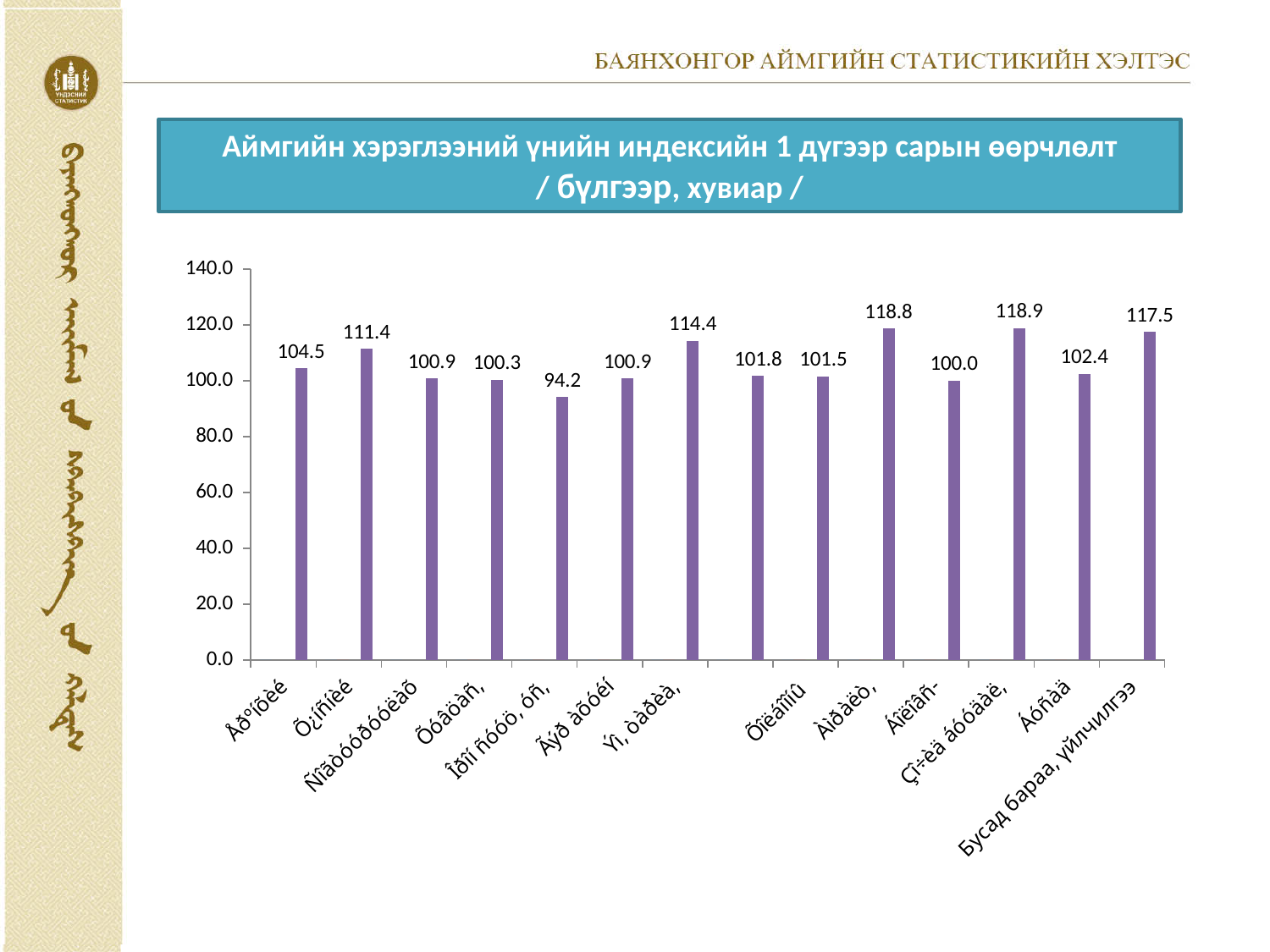
What type of chart is shown on the slide? bar chart What is the highest value shown in the chart? 118.9 Which is larger: the value of the leftmost bar or the value for "Бусад бараа, үйлчилгээ"? Бусад бараа, үйлчилгээ What is the value of the first (leftmost) bar in the chart? 104.5 What is the value for the category "Бусад бараа, үйлчилгээ"? 117.5 What is the title of the chart on the slide? Аймгийн хэрэглээний үнийн индексийн 1 дүгээр сарын өөрчлөлт / бүлгээр, хувиар / What is the difference between the highest value (118.9) and the lowest value (94.2) in the chart? 24.7 What is the value of the second bar from the left? 111.4 Is the value for "Бусад бараа, үйлчилгээ" greater or less than 100? greater What is the lowest value shown in the chart? 94.2 What is the difference between the value for "Бусад бараа, үйлчилгээ" and the value of the leftmost bar (104.5)? 13.0 How many bars are plotted in the chart? 14